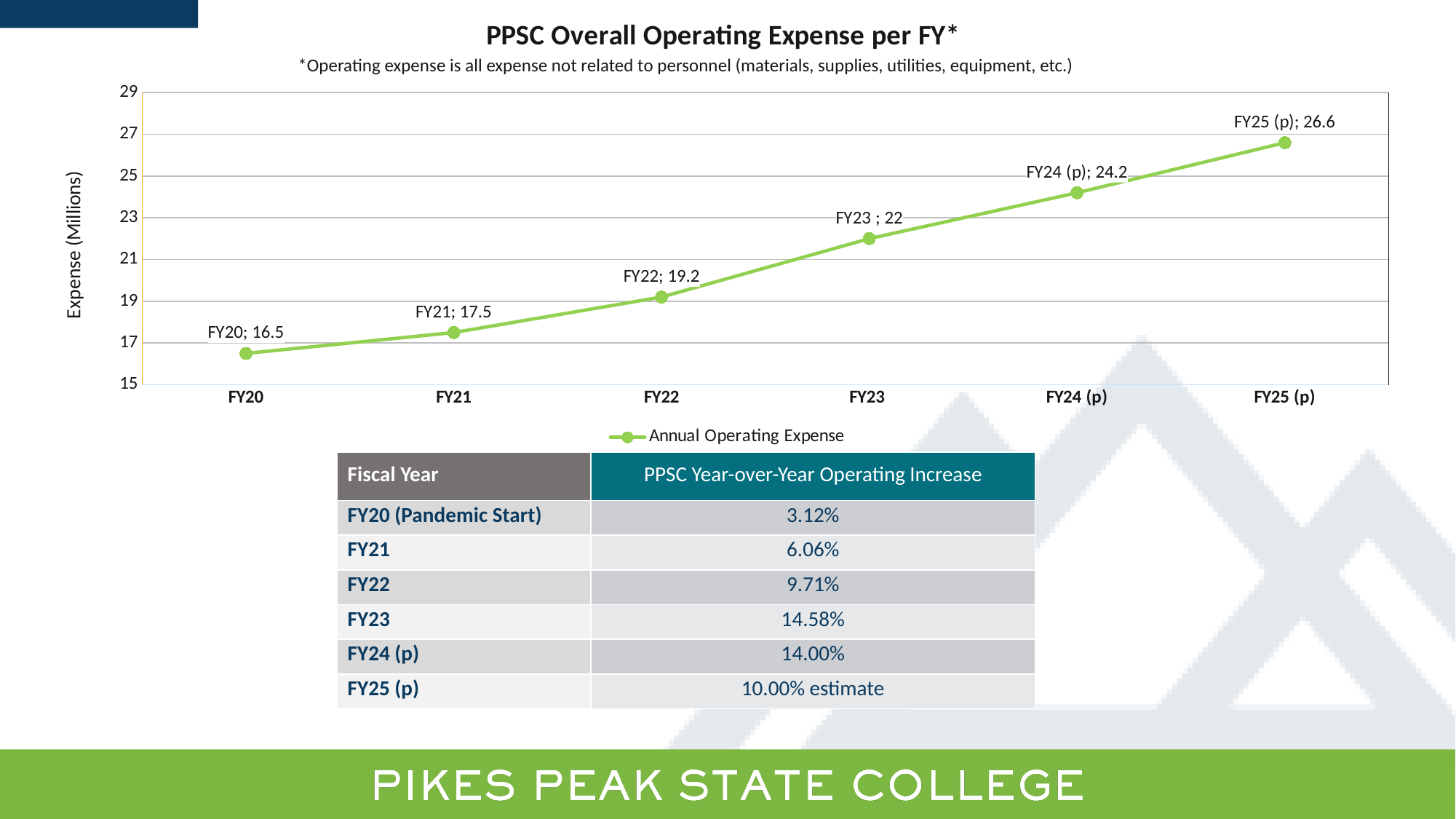
Which fiscal year has the highest annual operating expense? FY25 (p) What kind of chart is shown? line chart What is the difference between the operating expense for FY25 (p) and FY20? 10.1 Which fiscal year has the lowest annual operating expense? FY20 Do the values rise or fall from FY20 to FY25 (p)? rise How many fiscal years are plotted on the chart? 6 Is the value for FY24 (p) greater or less than 25? less What is the difference between the operating expense for FY23 and FY22? 2.8 What is the annual operating expense for FY24 (p)? 24.2 Which is larger, the operating expense for FY21 or FY23? FY23 What is the annual operating expense for FY22? 19.2 How many series does the legend list? 1